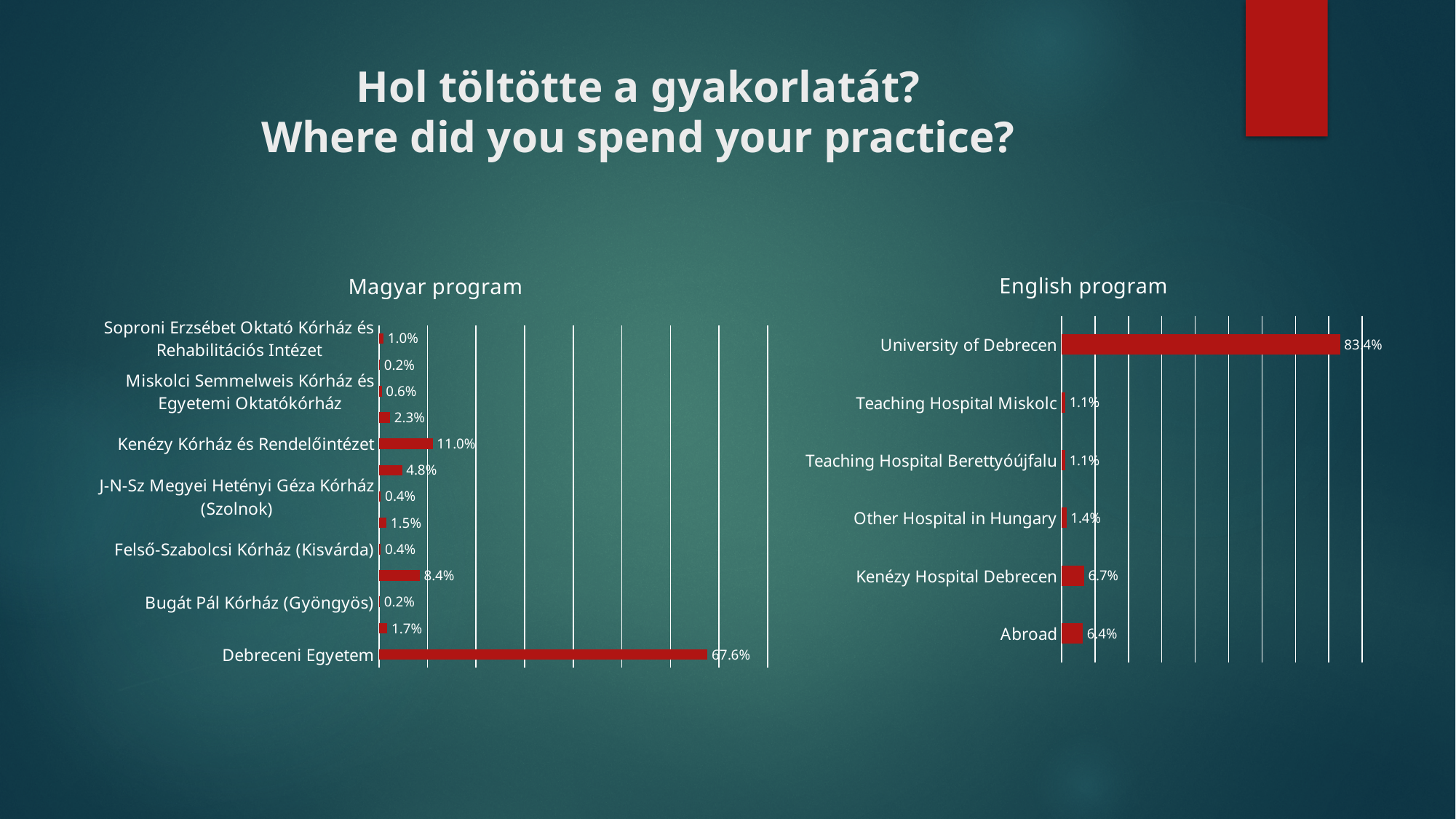
In the English program chart, what is the value for Kenézy Hospital Debrecen? 6.7% In the Magyar program chart, what is the value for Bugát Pál Kórház (Gyöngyös)? 0.2% In the English program chart, what is the value for University of Debrecen? 83.4% In the Magyar program chart, which is larger: Kenézy Kórház és Rendelőintézet or Soproni Erzsébet Oktató Kórház és Rehabilitációs Intézet? Kenézy Kórház és Rendelőintézet In the Magyar program chart, which category has the highest value? Debreceni Egyetem In the English program chart, what is the difference between Kenézy Hospital Debrecen and Abroad? 0.3% In the Magyar program chart, what is the value for Debreceni Egyetem? 67.6% In the English program chart, what is the value for Abroad? 6.4% What kind of chart is the English program chart? Bar chart In the Magyar program chart, what is the value for Kenézy Kórház és Rendelőintézet? 11.0% In the English program chart, how many categories are shown? 6 In the English program chart, which category has the highest value? University of Debrecen